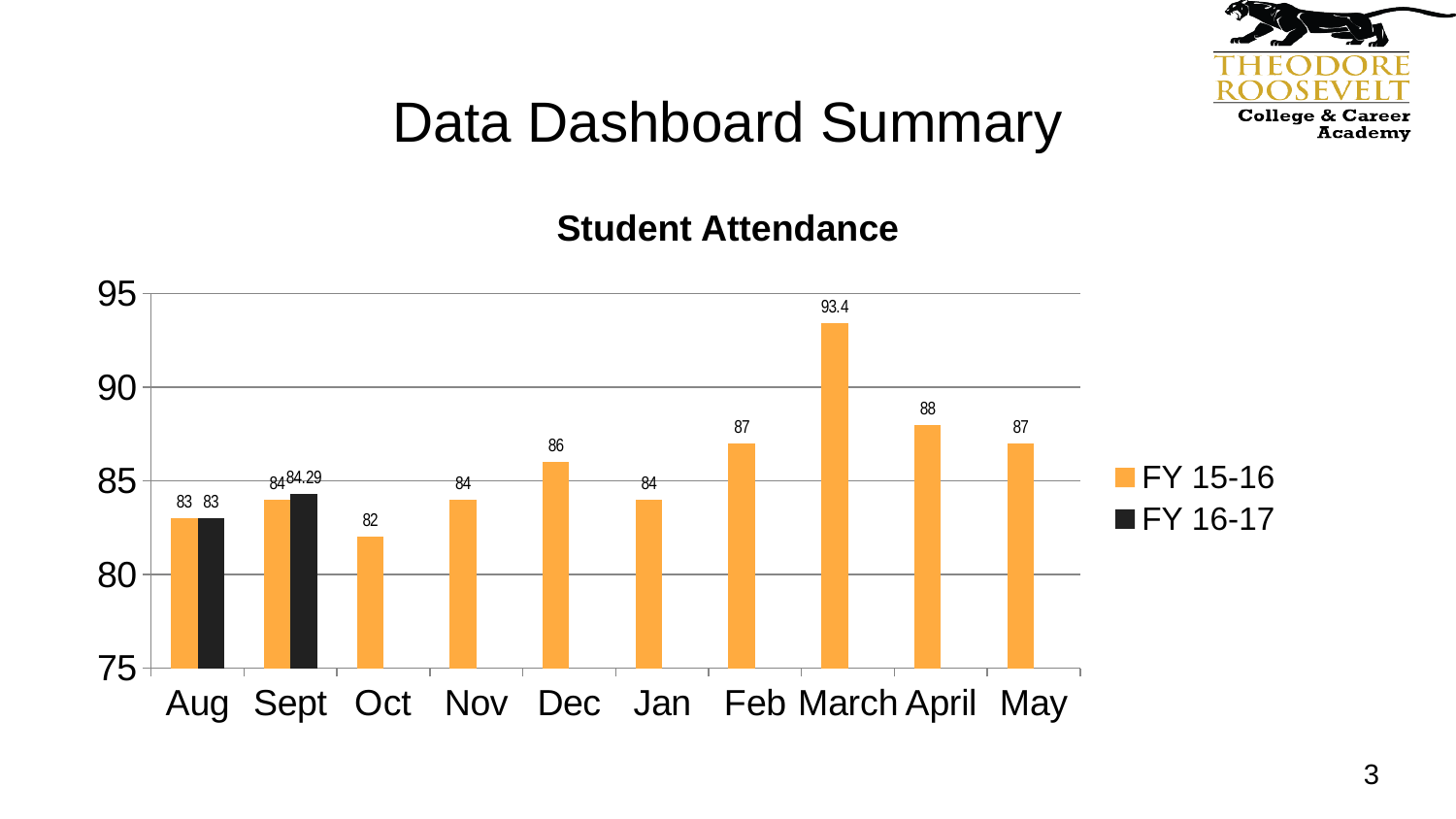
How many series does the legend list? 2 Is the FY 15-16 value for March greater or less than 90? greater What is the FY 15-16 student attendance value for Oct? 82 What is the FY 15-16 student attendance value for March? 93.4 What is the title of the chart? Student Attendance How many months are shown on the x axis? 10 Which is larger, the FY 15-16 value for Dec or the FY 15-16 value for Feb? Feb What is the difference between the FY 15-16 values for March and April? 5.4 What is the FY 16-17 student attendance value for Sept? 84.29 Which month has the lowest FY 15-16 attendance value? Oct What kind of chart is shown on the slide? Bar chart Which month has the highest FY 15-16 attendance value? March